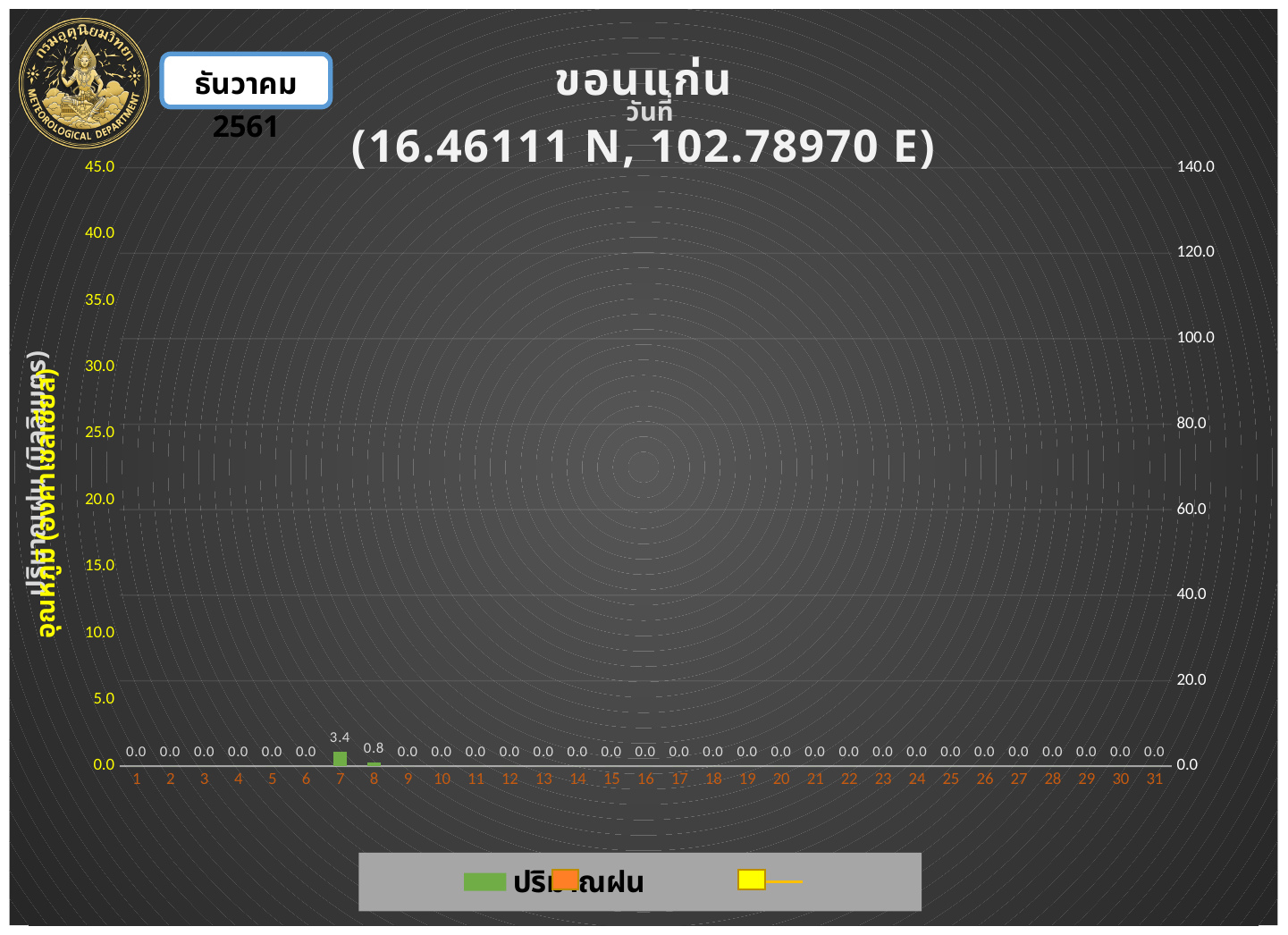
Which has the larger rainfall value, day 7 or day 8? day 7 Is the rainfall value for day 7 greater or less than 5.0? less What is the rainfall value for day 8? 0.8 What is the highest tick value on the left y axis? 45.0 What is the rainfall value for day 7? 3.4 What is the rainfall value for day 15? 0.0 What is the difference between the rainfall values for day 7 and day 8? 2.6 Which day has the highest rainfall value? 7 How many days are shown on the x axis? 31 What is the rainfall value for day 31? 0.0 What is the highest tick value on the right y axis? 140.0 What kind of chart is used to show the rainfall data? bar chart